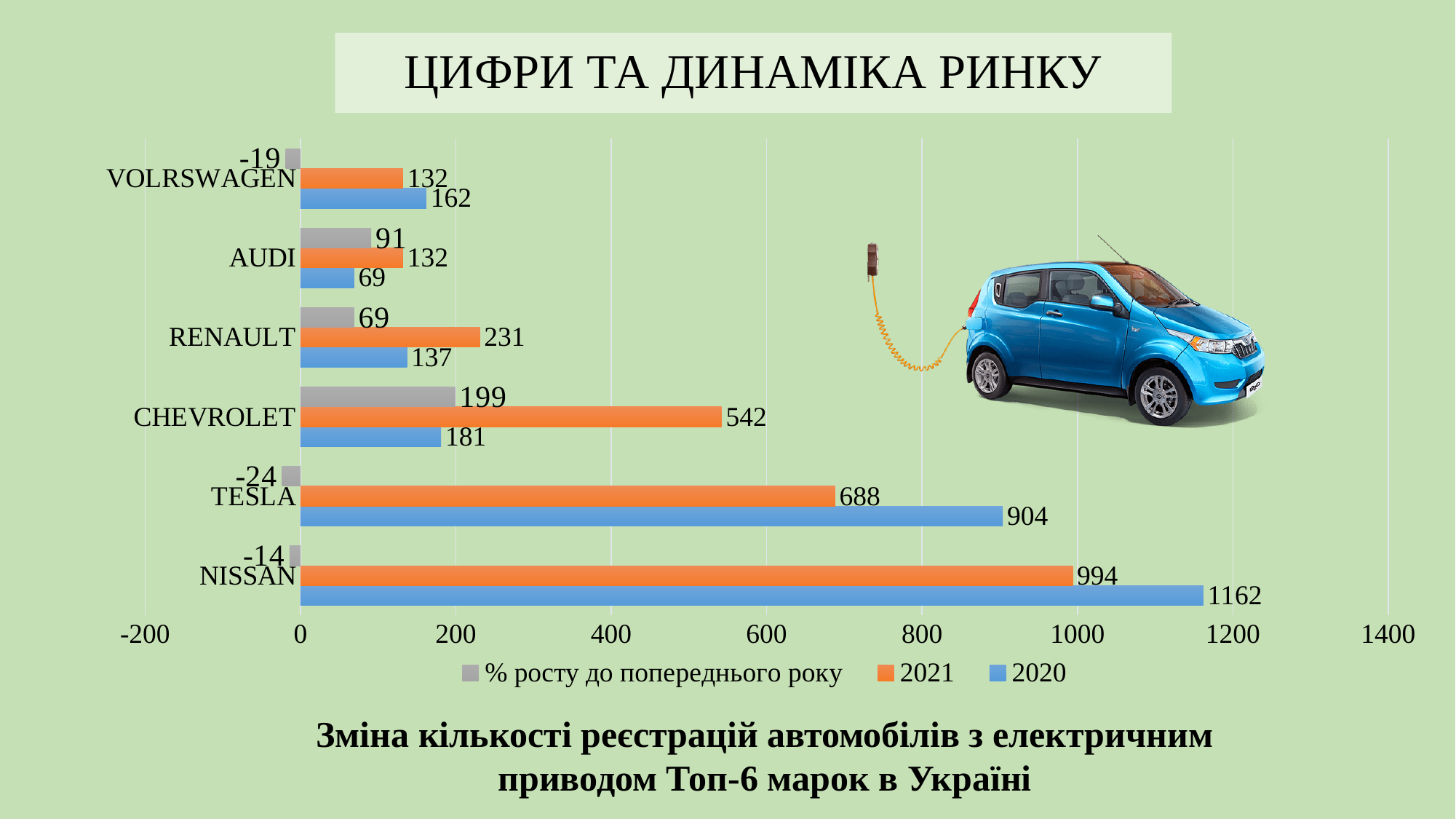
Which brand has the lowest 2021 value? AUDI and VOLRSWAGEN (both 132) Which brand has the highest 2020 value? NISSAN What kind of chart is shown on the slide? bar chart What is the '% росту до попереднього року' value for AUDI? 91 Which is larger for RENAULT: the 2021 value or the 2020 value? 2021 What is the 2021 value for CHEVROLET? 542 What colour represents the 2020 series in the legend? blue What is the 2020 value for TESLA? 904 What is the difference between the 2020 and 2021 values for NISSAN? 168 Which brand has the lowest '% росту до попереднього року' value? TESLA How many series does the legend list? 3 How many brands are shown on the chart? 6